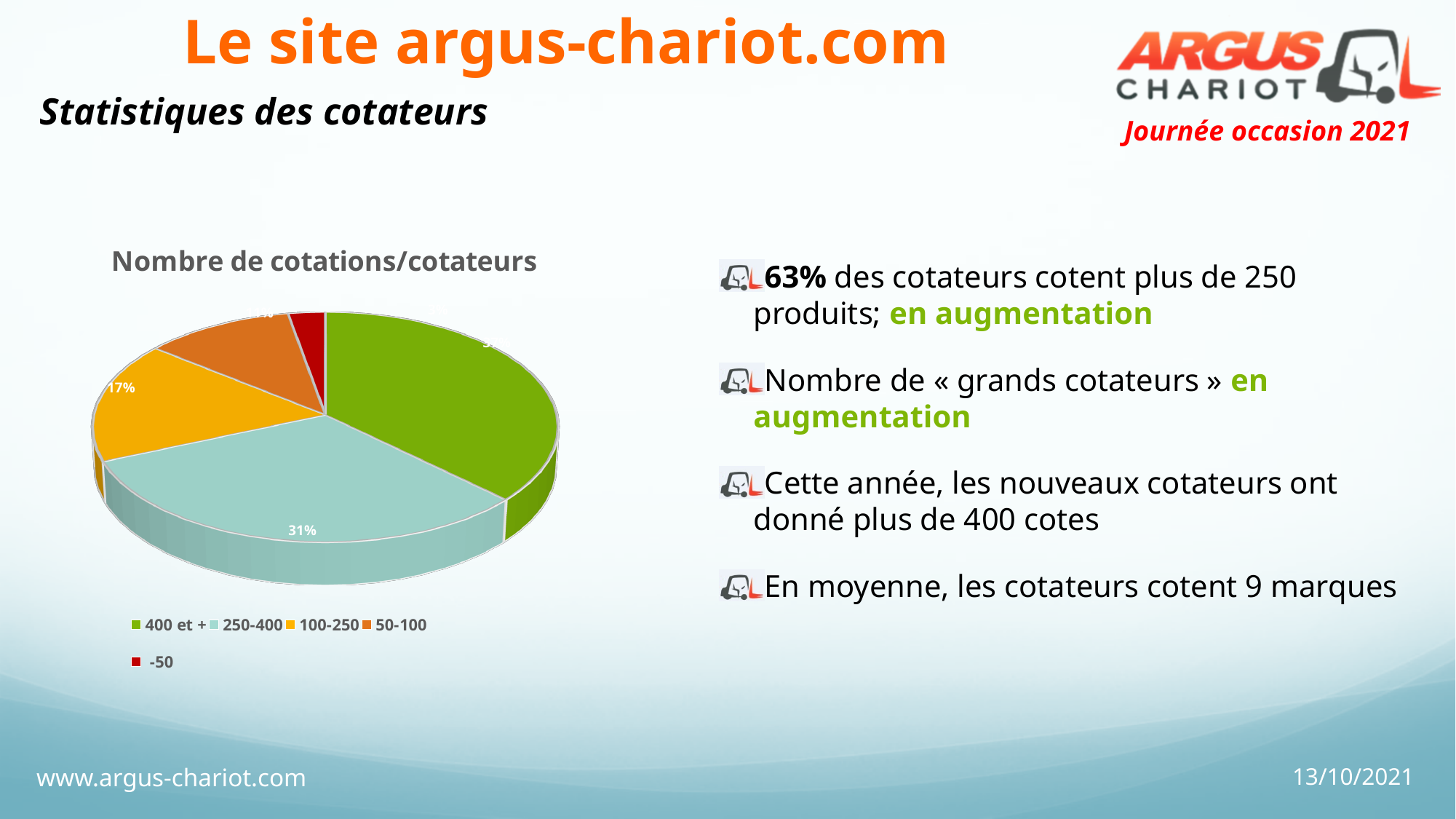
What is the value shown for the 100-250 category? 17% Which is larger, the 50-100 slice or the -50 slice? 50-100 What share of the pie does the 250-400 category represent? 31% What is the difference in percentage points between the 250-400 slice and the 100-250 slice? 14 How many categories does the pie chart's legend list? 5 Which category has the smallest slice of the pie? -50 Which is larger, the 250-400 slice or the 100-250 slice? 250-400 What is the title of the chart? Nombre de cotations/cotateurs Which colour represents the 400 et + category in the legend? Green What kind of chart is shown on the slide? Pie chart